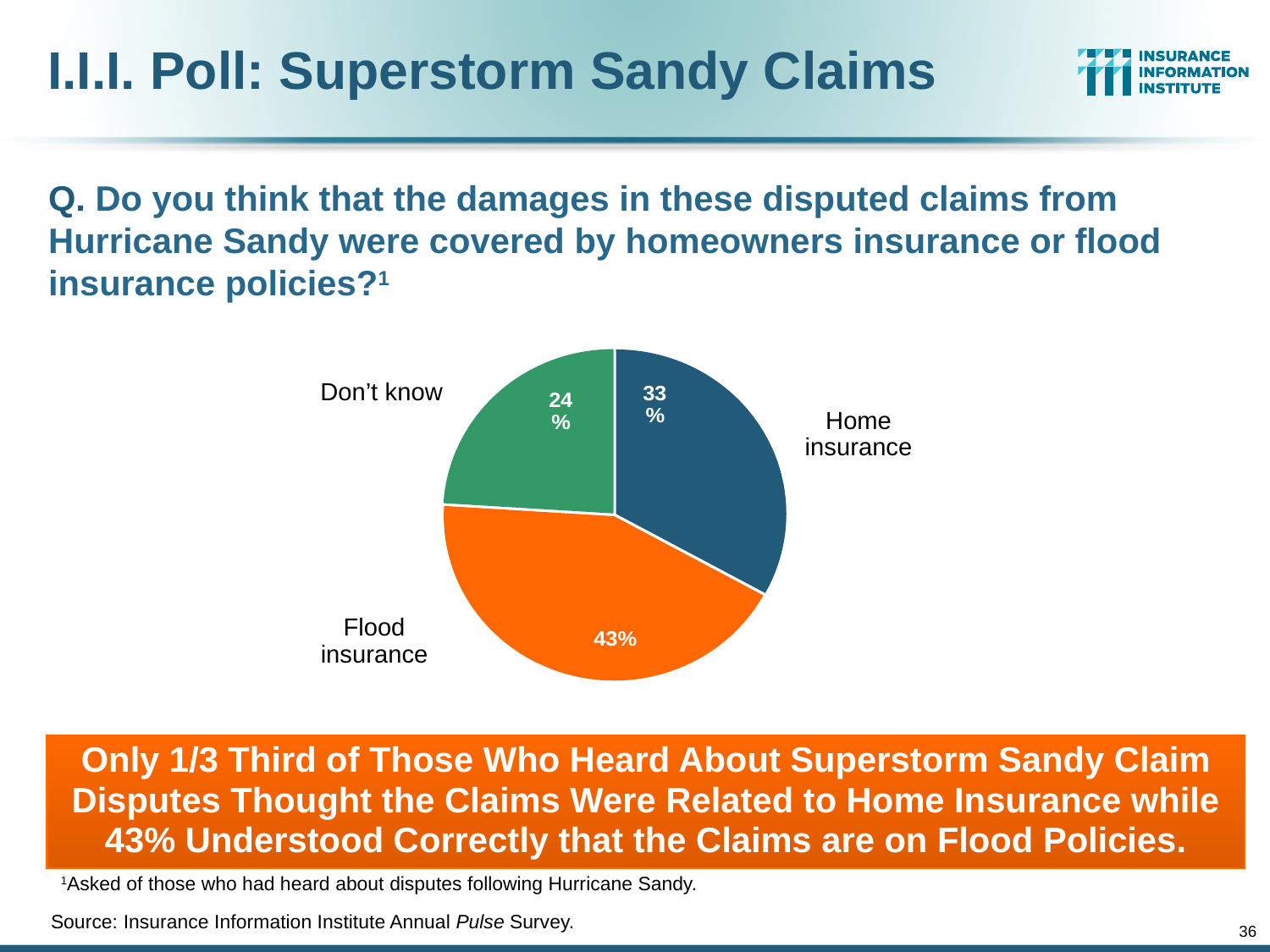
Which is larger, the Home insurance slice or the Don't know slice? Home insurance What colour is the Don't know slice? Green What kind of chart is shown on the slide? Pie chart What percentage of respondents said the damages were covered by home insurance? 33% How many slices does the pie chart have? 3 What percentage of respondents answered "Don't know"? 24% What is the difference in percentage points between the Home insurance and Don't know slices? 9 Which response has the smallest share of the pie? Don't know What colour is the Flood insurance slice? Orange What percentage of respondents said the damages were covered by flood insurance? 43% What is the difference in percentage points between the Flood insurance and Home insurance slices? 10 Which response has the largest share of the pie? Flood insurance